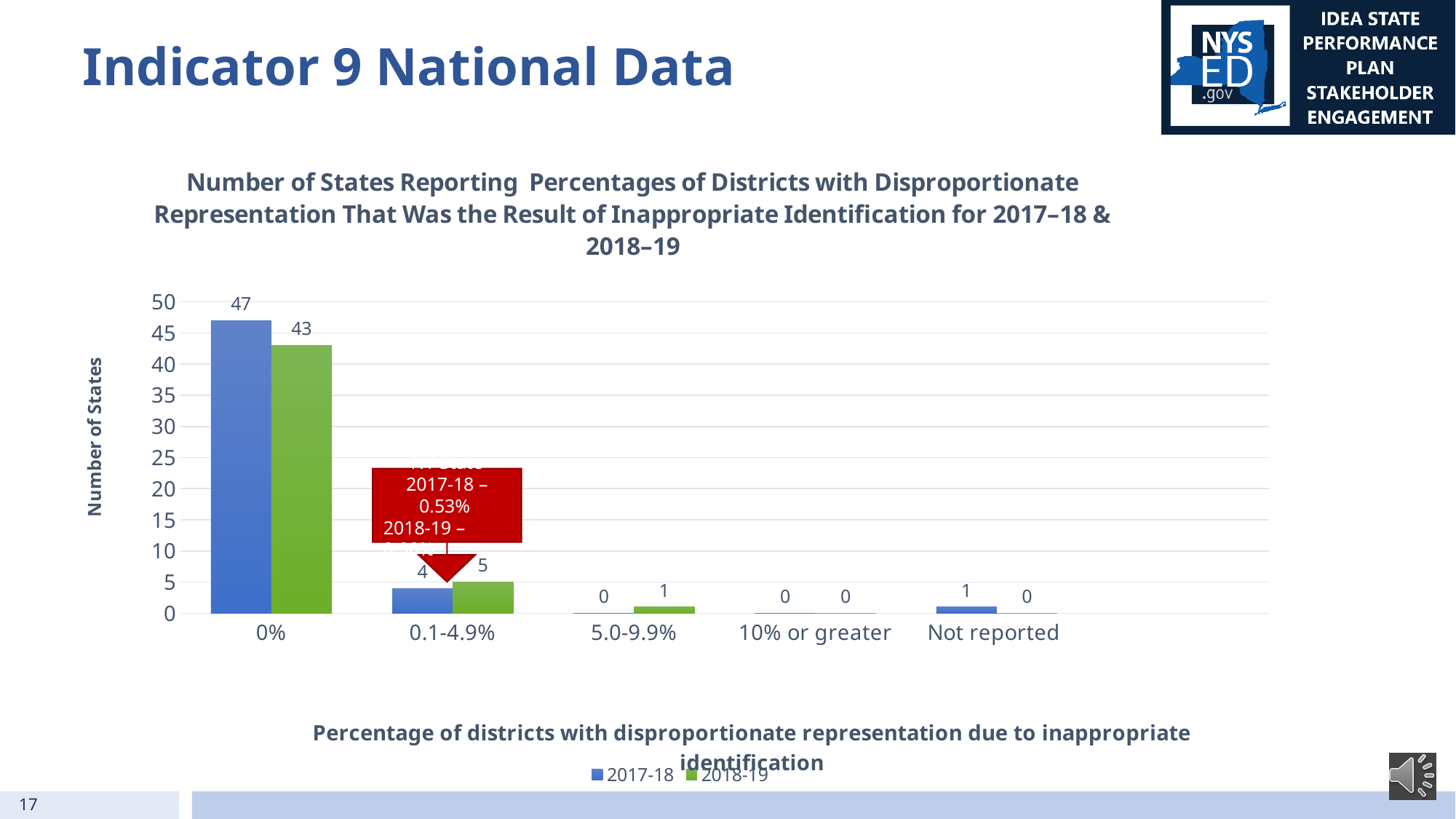
Which category has the highest number of states for 2017-18? 0% How many categories are shown on the x axis? 5 How many series does the legend list? 2 For the 0.1-4.9% category, which series has the larger value, 2017-18 or 2018-19? 2018-19 What is the value for the Not reported category in the 2017-18 series? 1 What is the value for the 0.1-4.9% category in the 2018-19 series? 5 What is the label of the y axis? Number of States What is the total of the 2017-18 and 2018-19 values for the 5.0-9.9% category? 1 How many states reported 0% for 2018-19? 43 What kind of chart is shown on the slide? bar chart What is the difference between the 2017-18 and 2018-19 values for the 0% category? 4 How many states reported 0% for 2017-18? 47